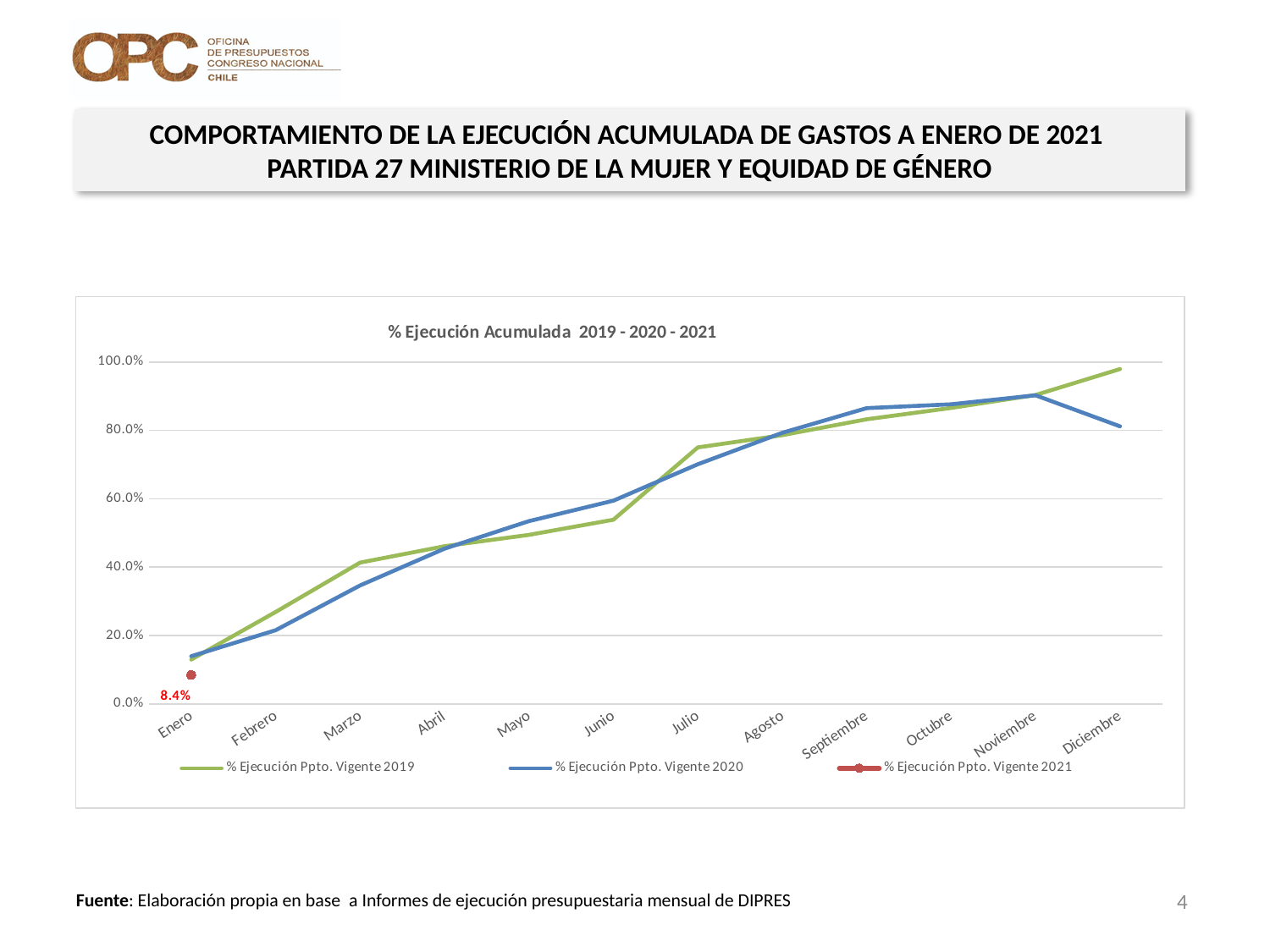
In Diciembre, which series is higher: % Ejecución Ppto. Vigente 2019 or % Ejecución Ppto. Vigente 2020? % Ejecución Ppto. Vigente 2019 How many series does the legend list? 3 What is the value of % Ejecución Ppto. Vigente 2021 for Enero? 8.4% In Marzo, which series is higher: % Ejecución Ppto. Vigente 2019 or % Ejecución Ppto. Vigente 2020? % Ejecución Ppto. Vigente 2019 Does the % Ejecución Ppto. Vigente 2019 line rise or fall from Enero to Diciembre? Rises What is the title of the chart? % Ejecución Acumulada 2019 - 2020 - 2021 What kind of chart is shown on the slide? Line chart Is the value for % Ejecución Ppto. Vigente 2020 in Febrero greater or less than 40.0%? less Is the value for % Ejecución Ppto. Vigente 2020 in Julio greater or less than 60.0%? greater How many months are shown along the x axis? 12 Is the value for % Ejecución Ppto. Vigente 2019 in Diciembre greater or less than 80.0%? greater For % Ejecución Ppto. Vigente 2019, which month has the highest value? Diciembre